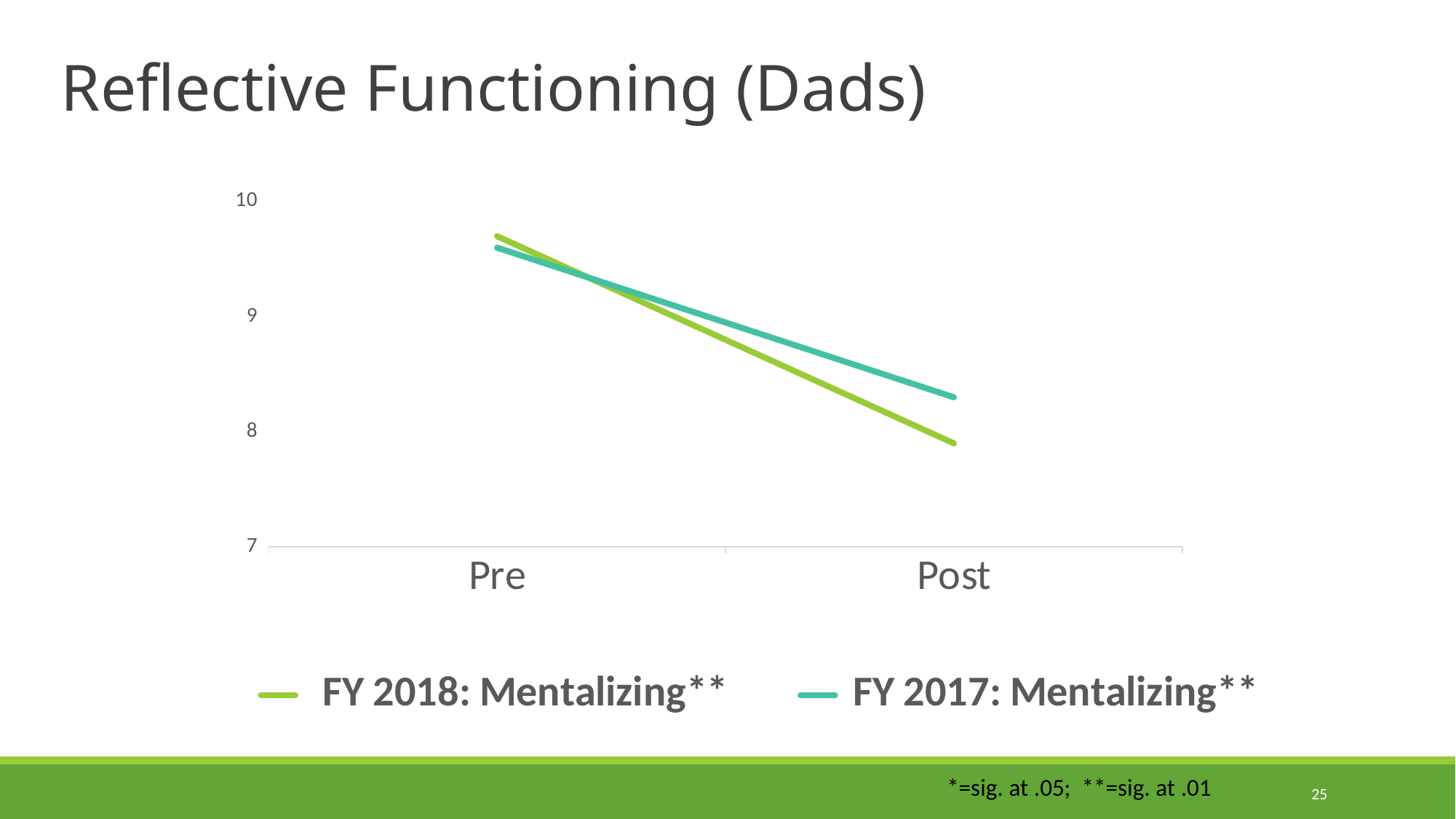
Which series is drawn in the teal line? FY 2017: Mentalizing** What kind of chart is shown on the slide? line chart How many categories are shown on the x axis? 2 Do the values for FY 2017: Mentalizing rise or fall from Pre to Post? fall Is the Pre value for FY 2018: Mentalizing greater or less than 9? greater Is the Post value for FY 2017: Mentalizing greater or less than 8? greater What is the title of the slide containing the chart? Reflective Functioning (Dads) Is the Pre value for FY 2017: Mentalizing greater or less than 10? less Do the values for FY 2018: Mentalizing rise or fall from Pre to Post? fall How many series does the legend list? 2 At Post, which series has the higher value, FY 2018: Mentalizing or FY 2017: Mentalizing? FY 2017: Mentalizing